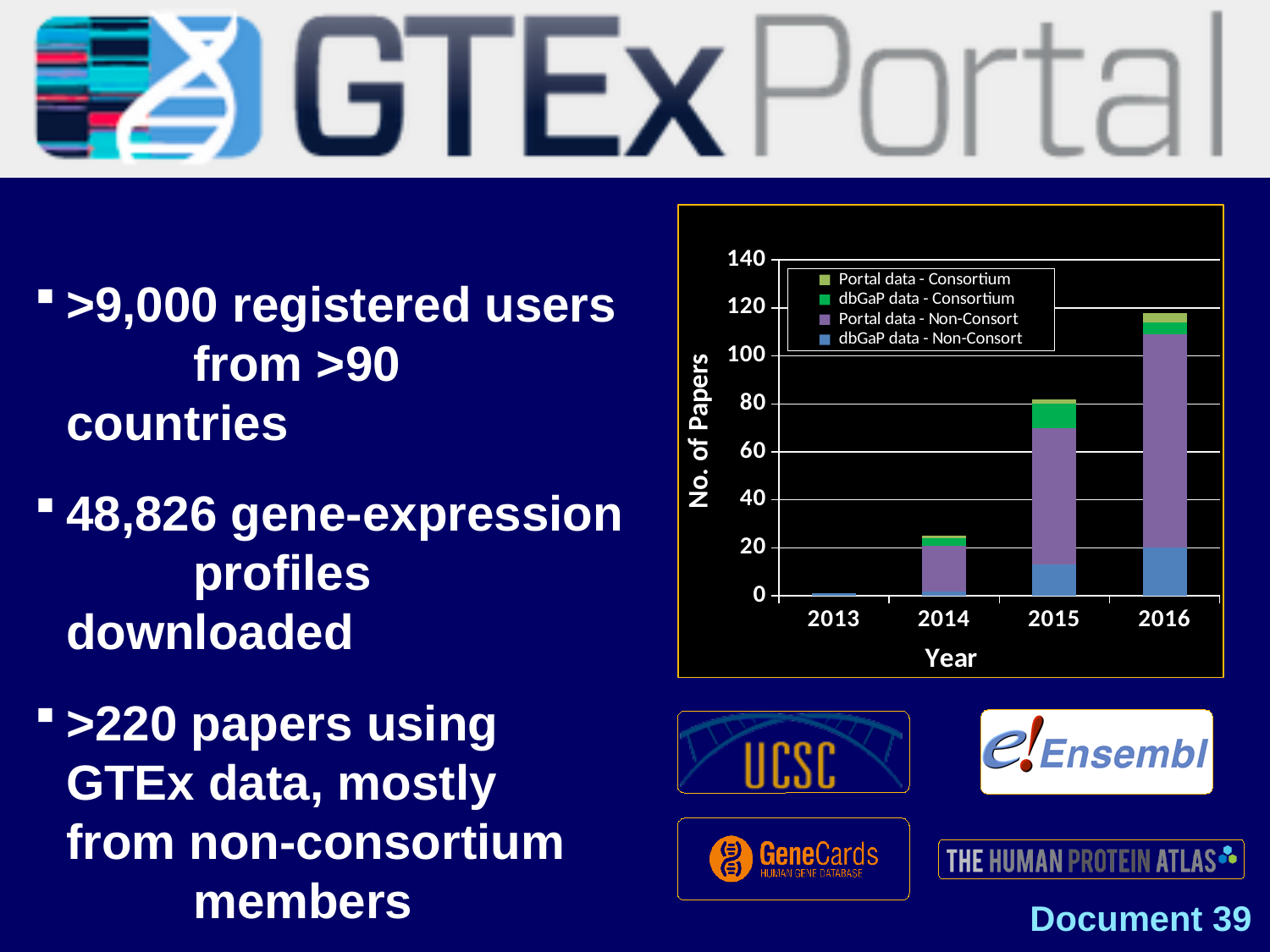
Is the total number of papers for 2016 greater or less than 100? greater What is the title of the chart's y axis? No. of Papers Do the total number of papers rise or fall from 2013 to 2016? rise What kind of chart is shown on the slide? stacked bar chart Which legend entry is shown in purple in the chart? Portal data - Non-Consort Which year has the shortest stacked bar in the chart? 2013 How many series does the chart's legend list? 4 Which year has the tallest stacked bar in the chart? 2016 How many years are shown on the x axis of the chart? 4 Is the total number of papers for 2014 greater or less than 40? less Which year has more papers in total, 2014 or 2015? 2015 Is the total number of papers for 2015 greater or less than 60? greater